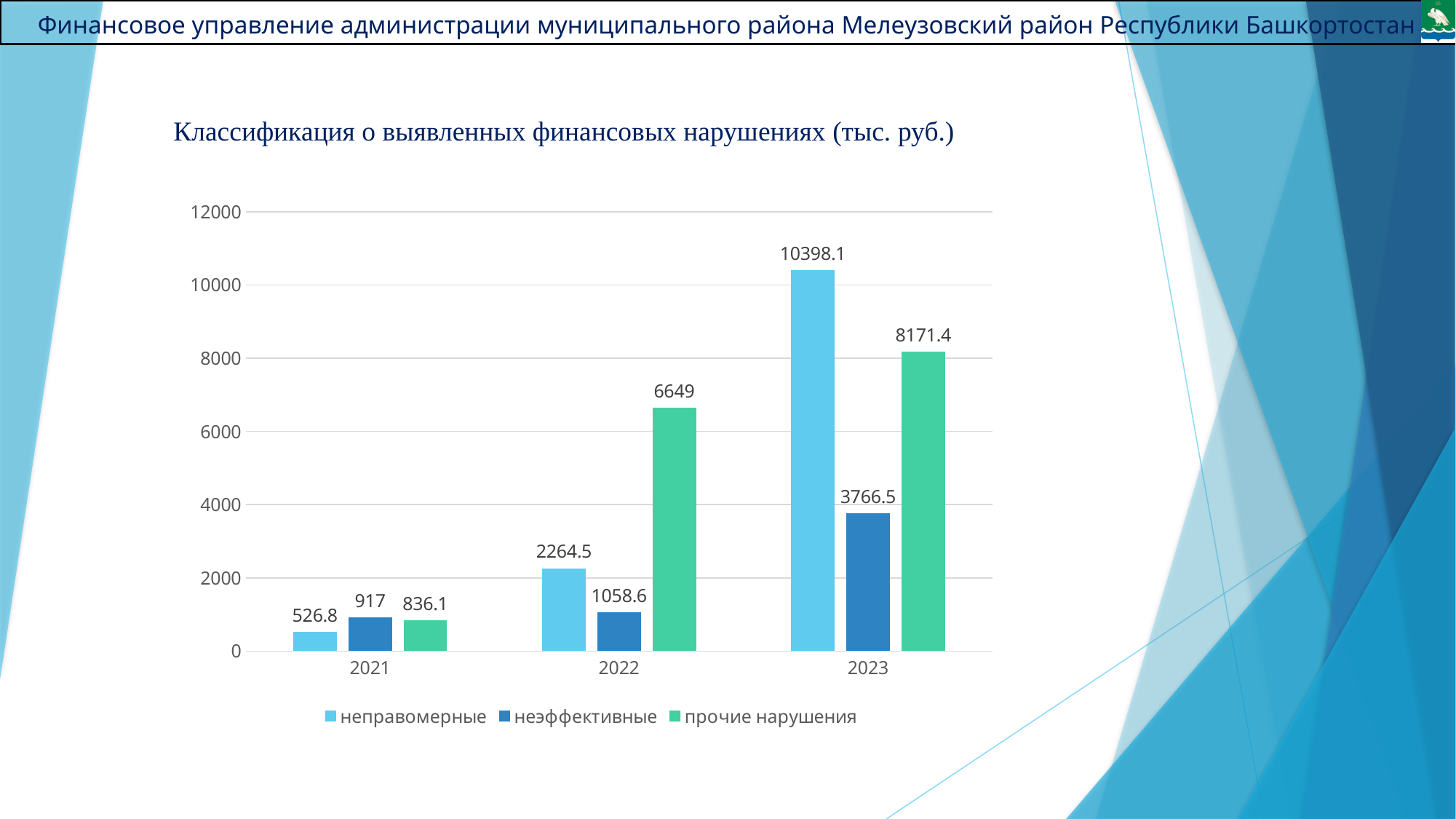
Is the value for неэффективные in 2023 greater or less than 4000? less What is the difference between неправомерные and неэффективные in 2023? 6631.6 Which year has the lowest value for прочие нарушения? 2021 How many years are shown on the x axis? 3 Which year has the highest value for неправомерные? 2023 What is the value for прочие нарушения in 2022? 6649 What is the value for неэффективные in 2021? 917 Which is larger in 2022: неправомерные or прочие нарушения? прочие нарушения What is the value for неправомерные in 2023? 10398.1 What kind of chart is shown on the slide? bar chart How many series does the legend list? 3 Do the values for неэффективные rise or fall from 2021 to 2023? rise